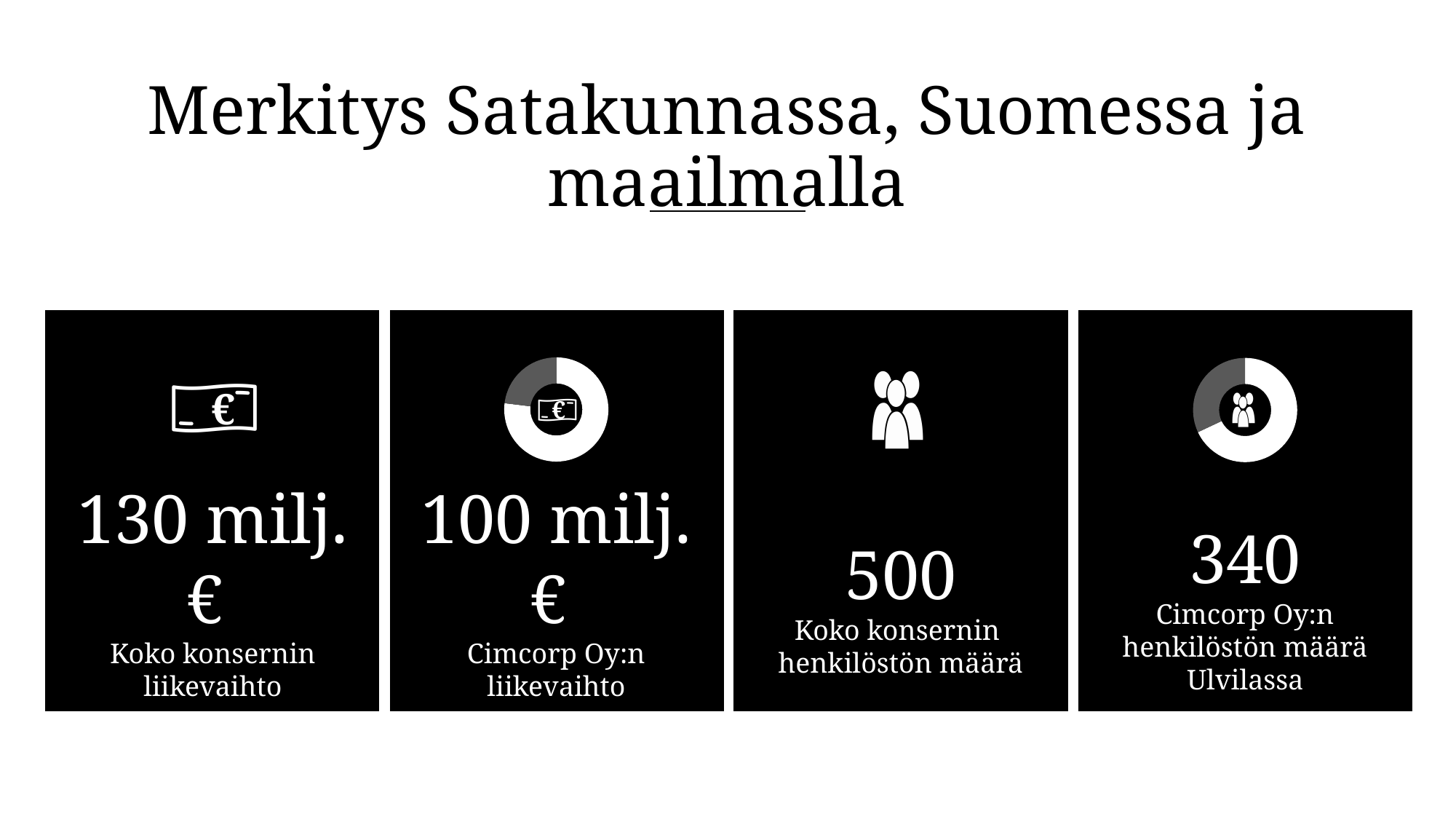
What is the difference between Koko konsernin henkilöstön määrä (500) and Cimcorp Oy:n henkilöstön määrä Ulvilassa (340)? 160 What kind of chart is shown in the rightmost tile (Cimcorp Oy:n henkilöstön määrä Ulvilassa)? Doughnut (pie) chart What is the difference between Koko konsernin liikevaihto (130 milj. €) and Cimcorp Oy:n liikevaihto (100 milj. €)? 30 milj. € In the doughnut chart in the second tile from the left, which slice is larger, the white one or the grey one? The white one What value is printed under the doughnut chart in the rightmost tile (Cimcorp Oy:n henkilöstön määrä Ulvilassa)? 340 How many slices does the doughnut chart in the rightmost tile have? 2 How many slices does the doughnut chart in the second tile from the left have? 2 What is the value shown for Koko konsernin henkilöstön määrä in the third tile from the left? 500 What value is printed under the doughnut chart in the second tile from the left (Cimcorp Oy:n liikevaihto)? 100 milj. € In the doughnut chart in the rightmost tile, which slice is larger, the white one or the grey one? The white one What kind of chart is shown in the second tile from the left (Cimcorp Oy:n liikevaihto)? Doughnut (pie) chart What is the value shown for Koko konsernin liikevaihto in the leftmost tile? 130 milj. €